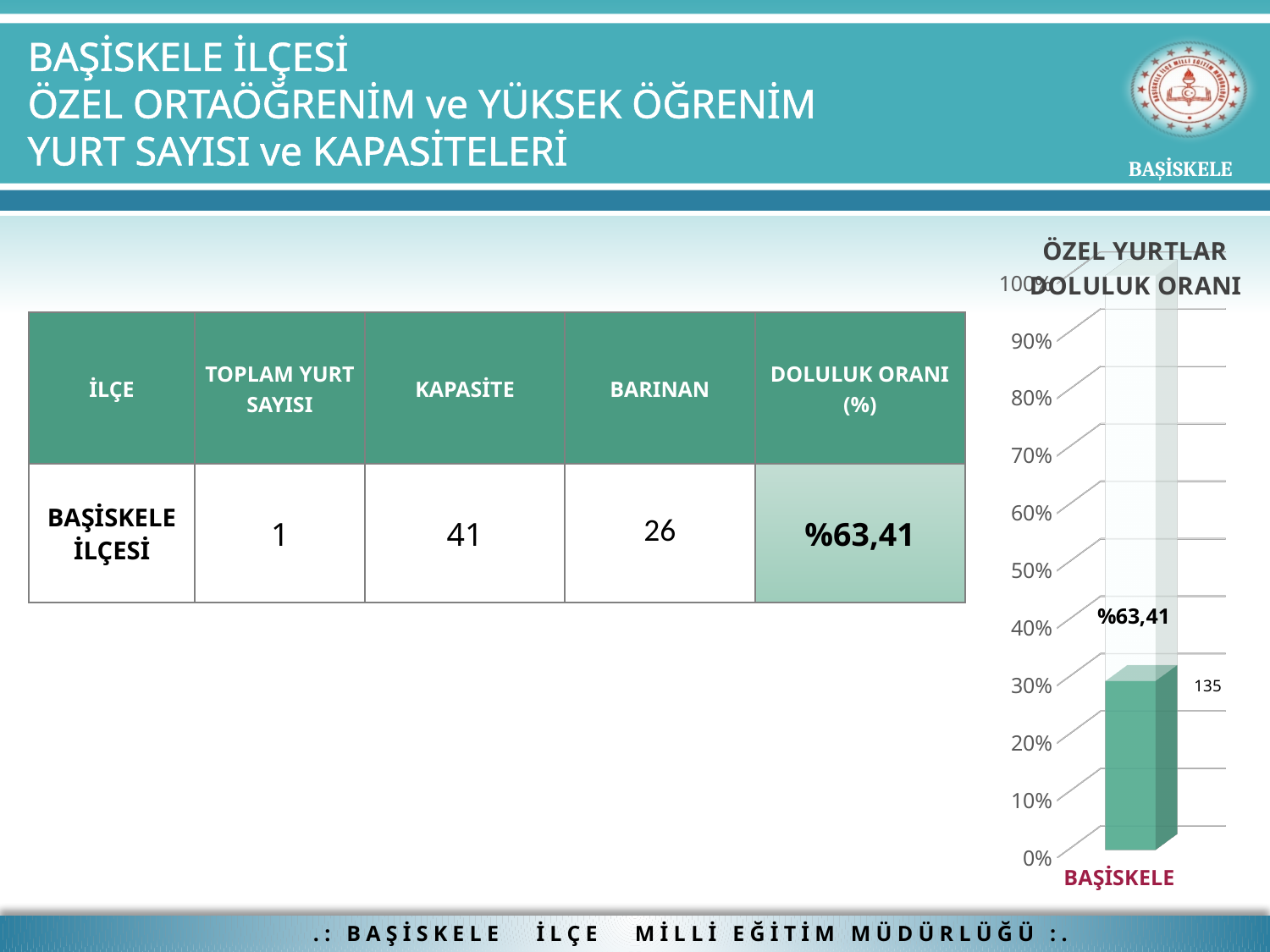
What is the category label shown on the x axis of the ÖZEL YURTLAR DOLULUK ORANI chart? BAŞİSKELE What is the lowest tick value shown on the vertical axis of the ÖZEL YURTLAR DOLULUK ORANI chart? 0% How many categories are plotted in the ÖZEL YURTLAR DOLULUK ORANI chart? 1 What is the title of the chart on the right side of the slide? ÖZEL YURTLAR DOLULUK ORANI What is the highest tick value shown on the vertical axis of the ÖZEL YURTLAR DOLULUK ORANI chart? 100% What kind of chart is shown on the right side of the slide? bar chart